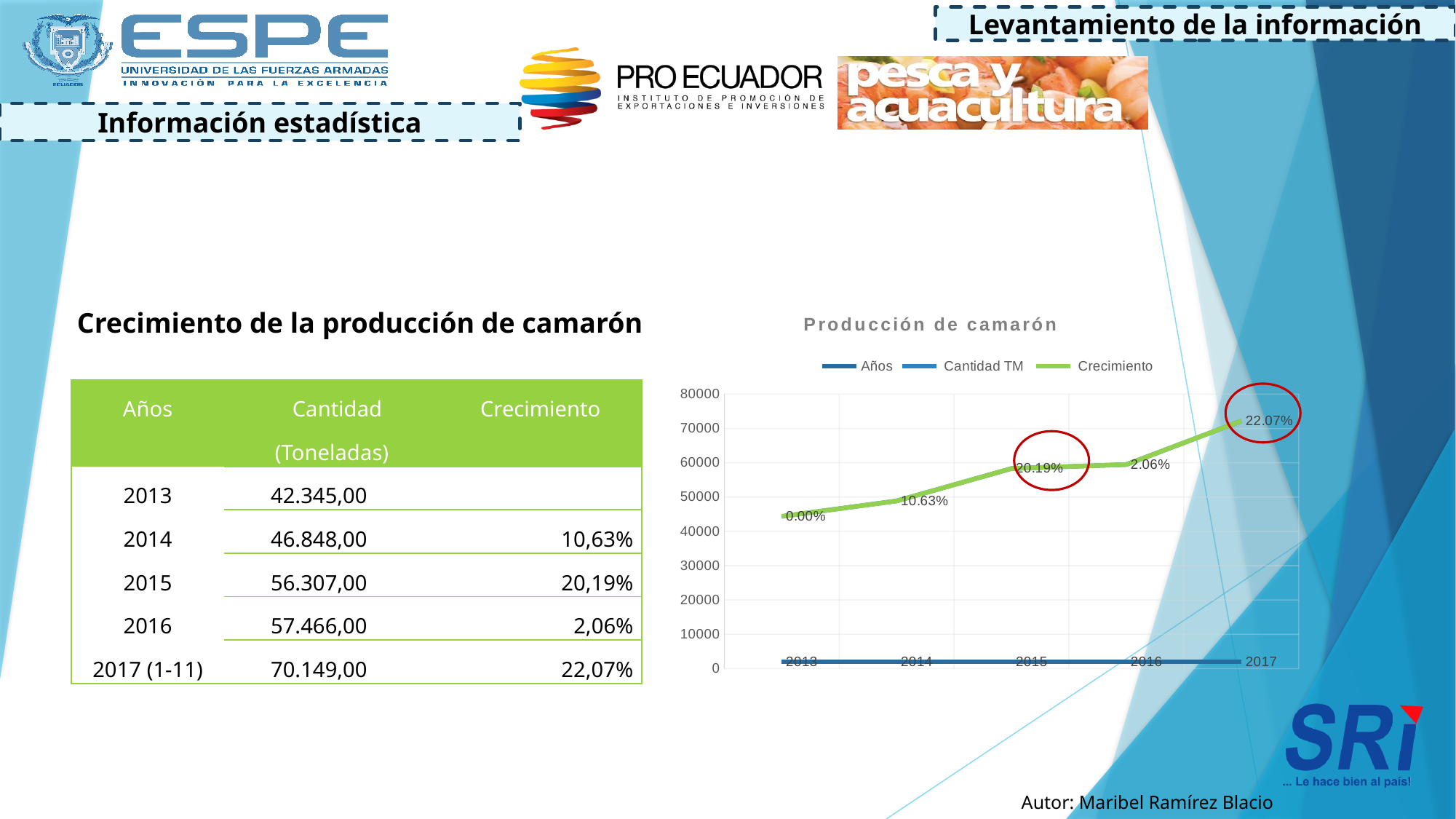
How many years are plotted along the x axis of the chart? 5 Which year has the highest Crecimiento data label? 2017 What data label is shown on the Crecimiento line for 2014? 10.63% What kind of chart is shown on the slide? line chart Which year has the lowest Crecimiento data label? 2013 What is the difference between the Crecimiento labels for 2017 and 2015? 1.88% What data label is shown on the Crecimiento line for 2017? 22.07% What is the title of the chart? Producción de camarón What data label is shown on the Crecimiento line for 2015? 20.19% How many series does the chart legend list? 3 Which is larger, the Crecimiento label for 2015 or for 2016? 2015